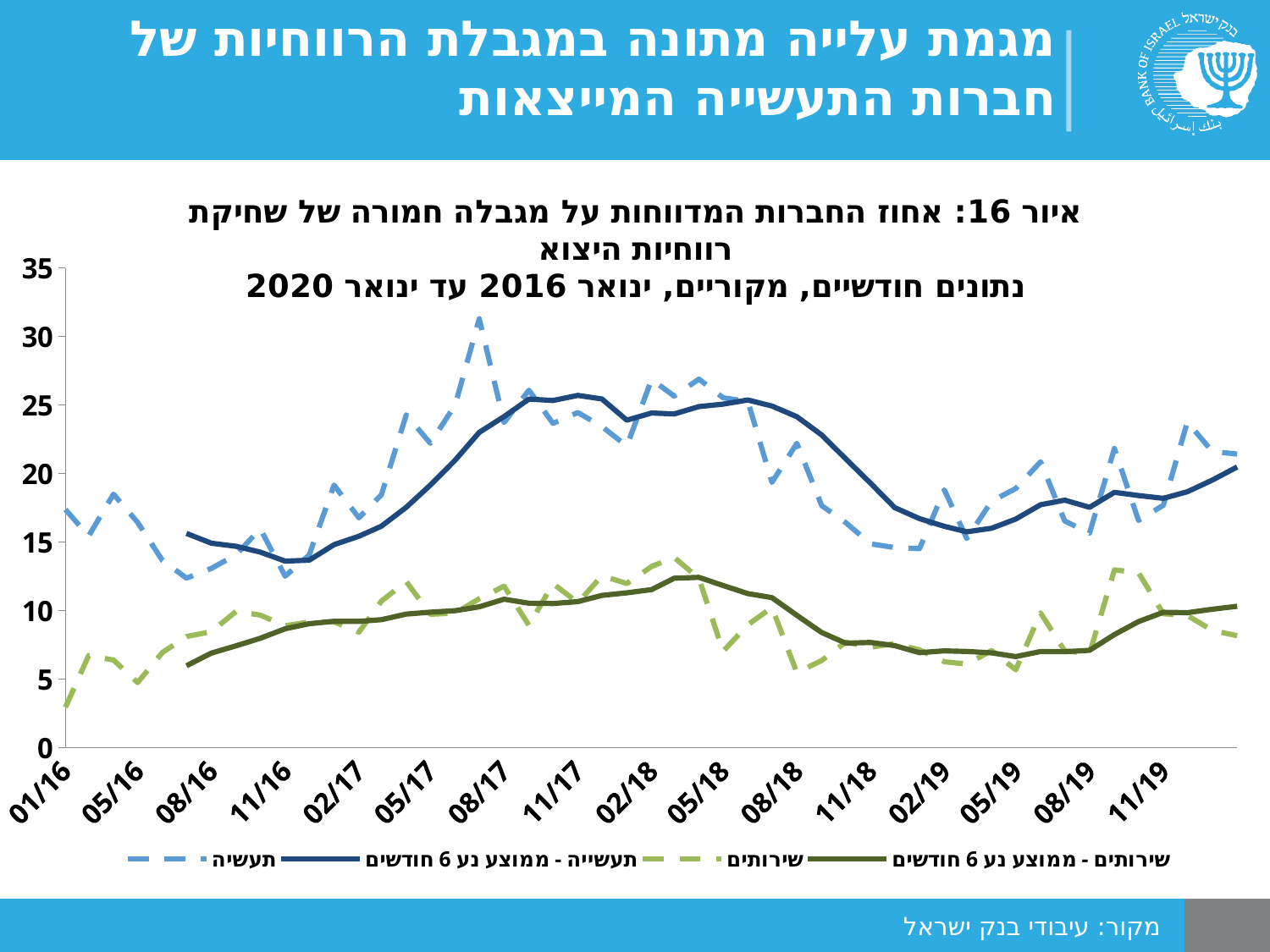
How many series does the legend list? 4 Which series is drawn as a dashed light-blue line? תעשייה What is the highest value shown on the vertical axis? 35 At 08/17, which series has the higher value: תעשייה or שירותים? תעשייה Is the peak value of the תעשייה series around 08/17 greater or less than 25? greater Is the value of the תעשייה - ממוצע נע 6 חודשים series at 11/16 greater or less than 15? less Is the value of the שירותים series at 01/16 greater or less than 5? less Does the תעשייה - ממוצע נע 6 חודשים series rise or fall between 05/18 and 02/19? fall Does the תעשייה - ממוצע נע 6 חודשים series rise or fall between 11/16 and 08/17? rise What kind of chart is shown on the slide? line chart